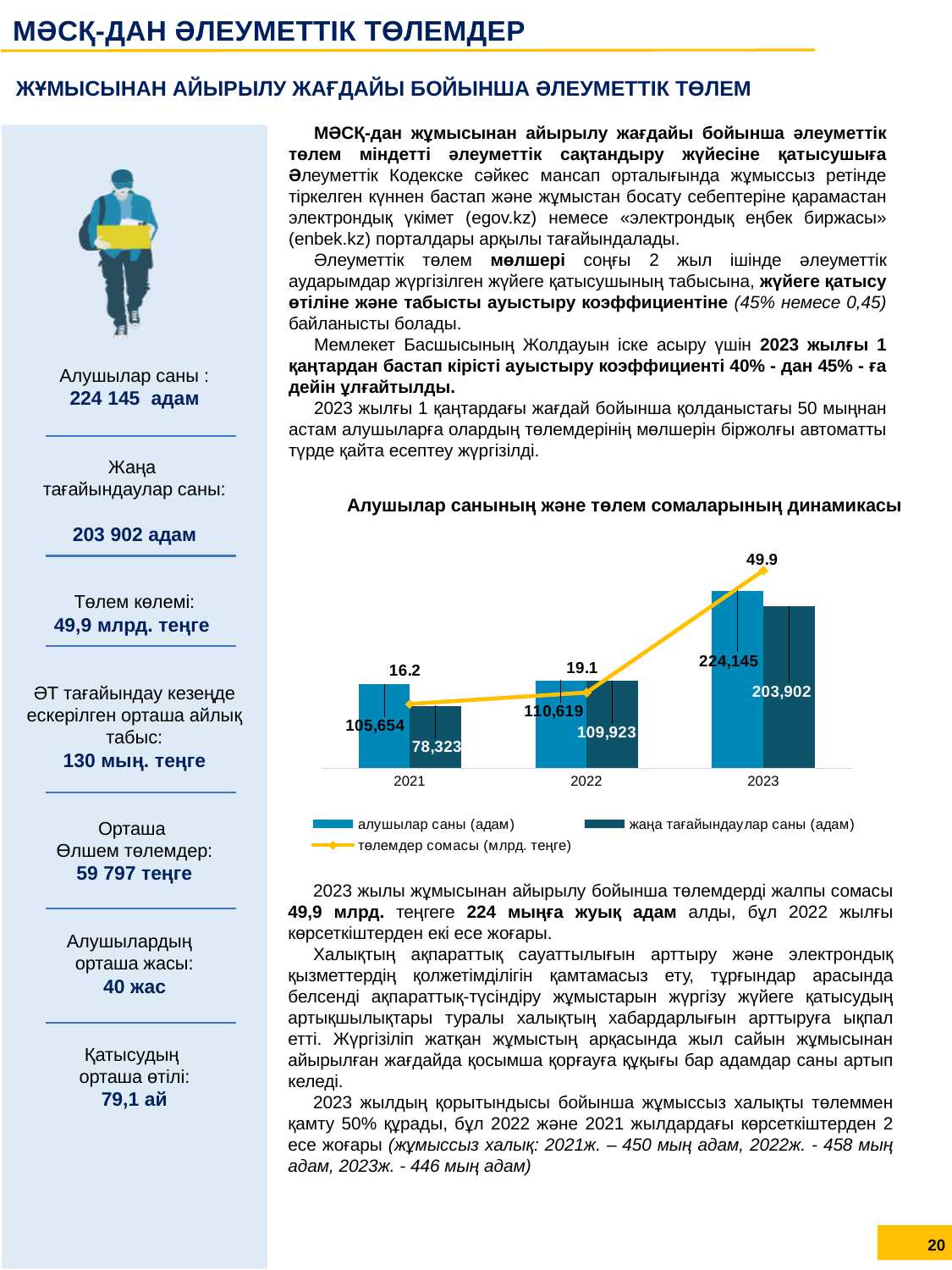
In the chart 'Алушылар санының және төлем сомаларының динамикасы', what is the difference between 'алушылар саны (адам)' and 'жаңа тағайындаулар саны (адам)' in 2023? 20,243 In the chart 'Алушылар санының және төлем сомаларының динамикасы', what is the value of 'жаңа тағайындаулар саны (адам)' for 2021? 78,323 How many series does the legend of the chart 'Алушылар санының және төлем сомаларының динамикасы' list? 3 In the chart 'Алушылар санының және төлем сомаларының динамикасы', which year has the lowest value of 'жаңа тағайындаулар саны (адам)'? 2021 In the chart 'Алушылар санының және төлем сомаларының динамикасы', what is the value of 'алушылар саны (адам)' for 2023? 224,145 In the chart 'Алушылар санының және төлем сомаларының динамикасы', which year has the highest value of 'төлемдер сомасы (млрд. теңге)'? 2023 How many years are shown on the x axis of the chart 'Алушылар санының және төлем сомаларының динамикасы'? 3 Does 'төлемдер сомасы (млрд. теңге)' rise or fall from 2021 to 2023 in the chart 'Алушылар санының және төлем сомаларының динамикасы'? rise In the chart 'Алушылар санының және төлем сомаларының динамикасы', what is the value of 'төлемдер сомасы (млрд. теңге)' for 2022? 19.1 In the chart 'Алушылар санының және төлем сомаларының динамикасы', which is larger: 'алушылар саны (адам)' in 2022 or 'жаңа тағайындаулар саны (адам)' in 2022? алушылар саны (адам) In the chart 'Алушылар санының және төлем сомаларының динамикасы', what is the difference in 'төлемдер сомасы (млрд. теңге)' between 2023 and 2022? 30.8 Which series in the chart 'Алушылар санының және төлем сомаларының динамикасы' is drawn as a line rather than bars? төлемдер сомасы (млрд. теңге)